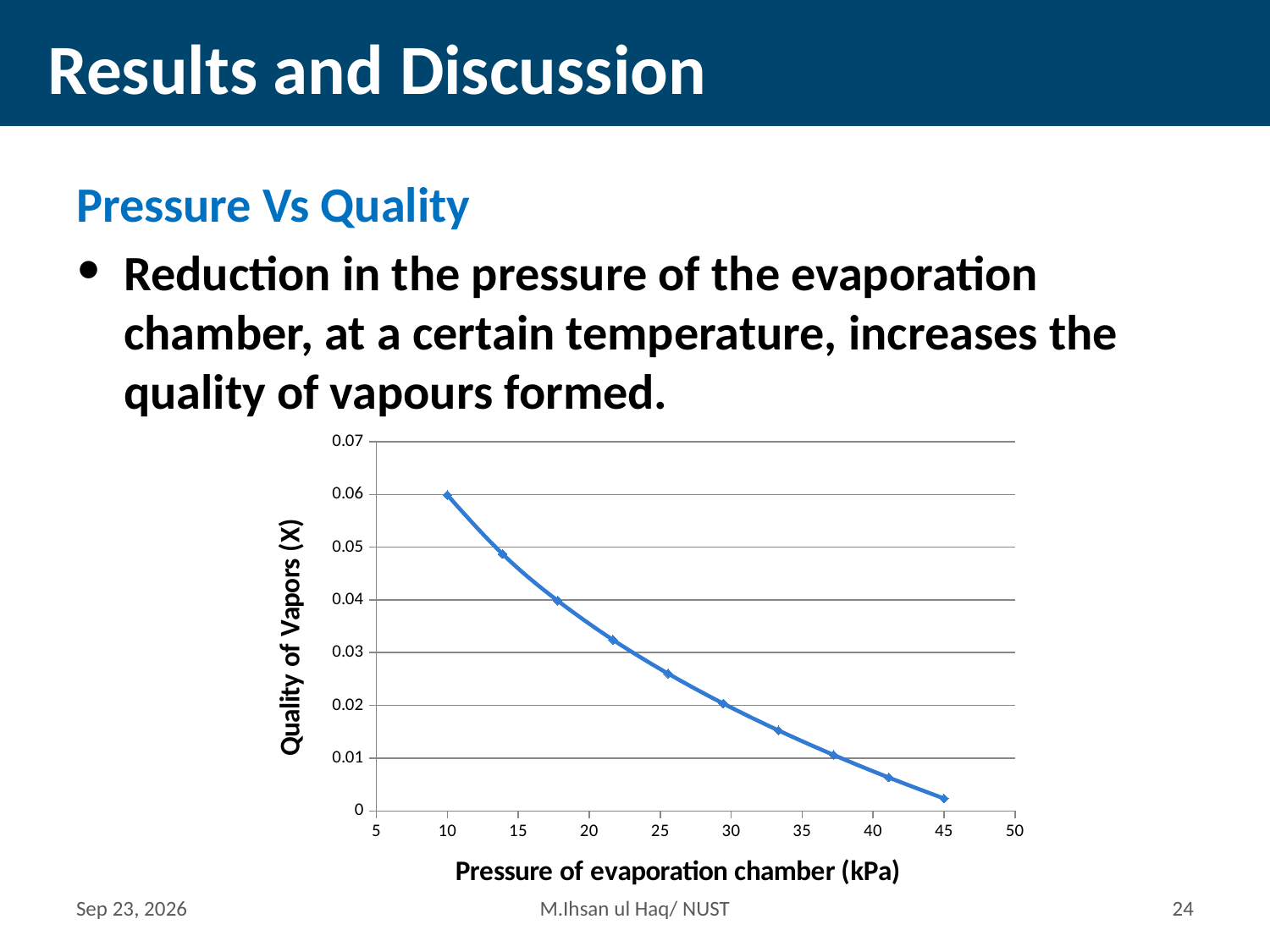
At which pressure is the quality of vapors lowest? 45 kPa What kind of chart is shown on the slide? line chart Which has a higher quality of vapors: the point at 10 kPa or the point at 45 kPa? 10 kPa How many data points are plotted on the chart? 10 What is the quality of vapors at a pressure of 10 kPa? 0.06 As the pressure of the evaporation chamber increases along the x axis, does the quality of vapors rise or fall? fall Is the quality of vapors at the data point near 25 kPa greater or less than 0.02? greater Is the quality of vapors at 45 kPa greater or less than 0.01? less Is the quality of vapors at the second data point (around 14 kPa) greater or less than 0.04? greater What is the label of the x axis of the chart? Pressure of evaporation chamber (kPa) What is the label of the y axis of the chart? Quality of Vapors (X) At which pressure is the quality of vapors highest? 10 kPa